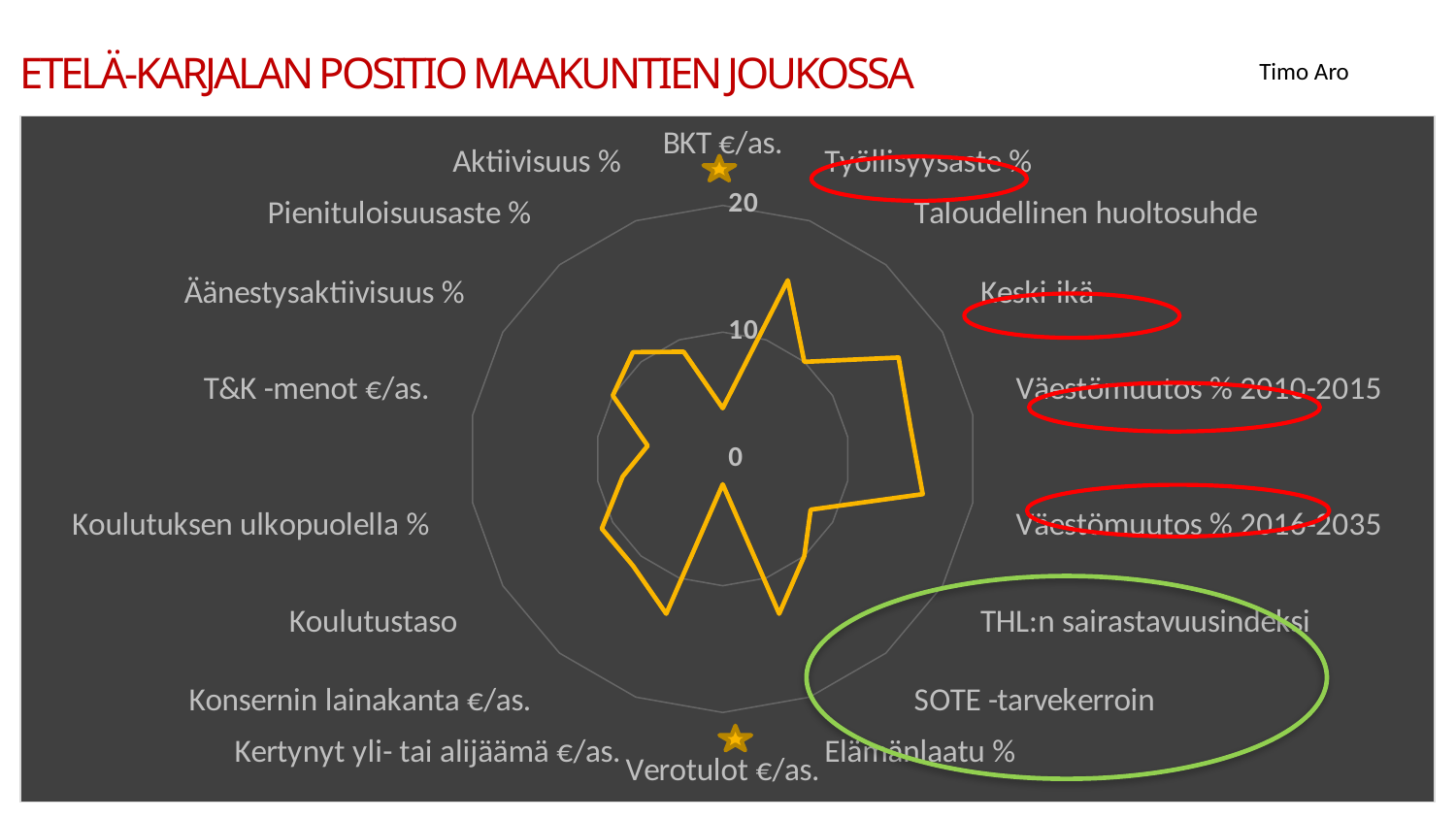
What kind of chart is shown on the slide? radar chart What is the highest value shown on the radar chart's axis? 20 Is the value for Työllisyysaste % greater or less than 10? greater Is the value for Keski-ikä greater or less than 10? greater Is the value for Verotulot €/as. greater or less than 10? less How many categories are plotted around the radar chart? 18 How many data series are plotted on the radar chart? 1 Which has the larger value, Väestömuutos % 2016-2035 or Verotulot €/as.? Väestömuutos % 2016-2035 Which has the larger value, Keski-ikä or Verotulot €/as.? Keski-ikä What is the title of the slide containing the radar chart? ETELÄ-KARJALAN POSITIO MAAKUNTIEN JOUKOSSA